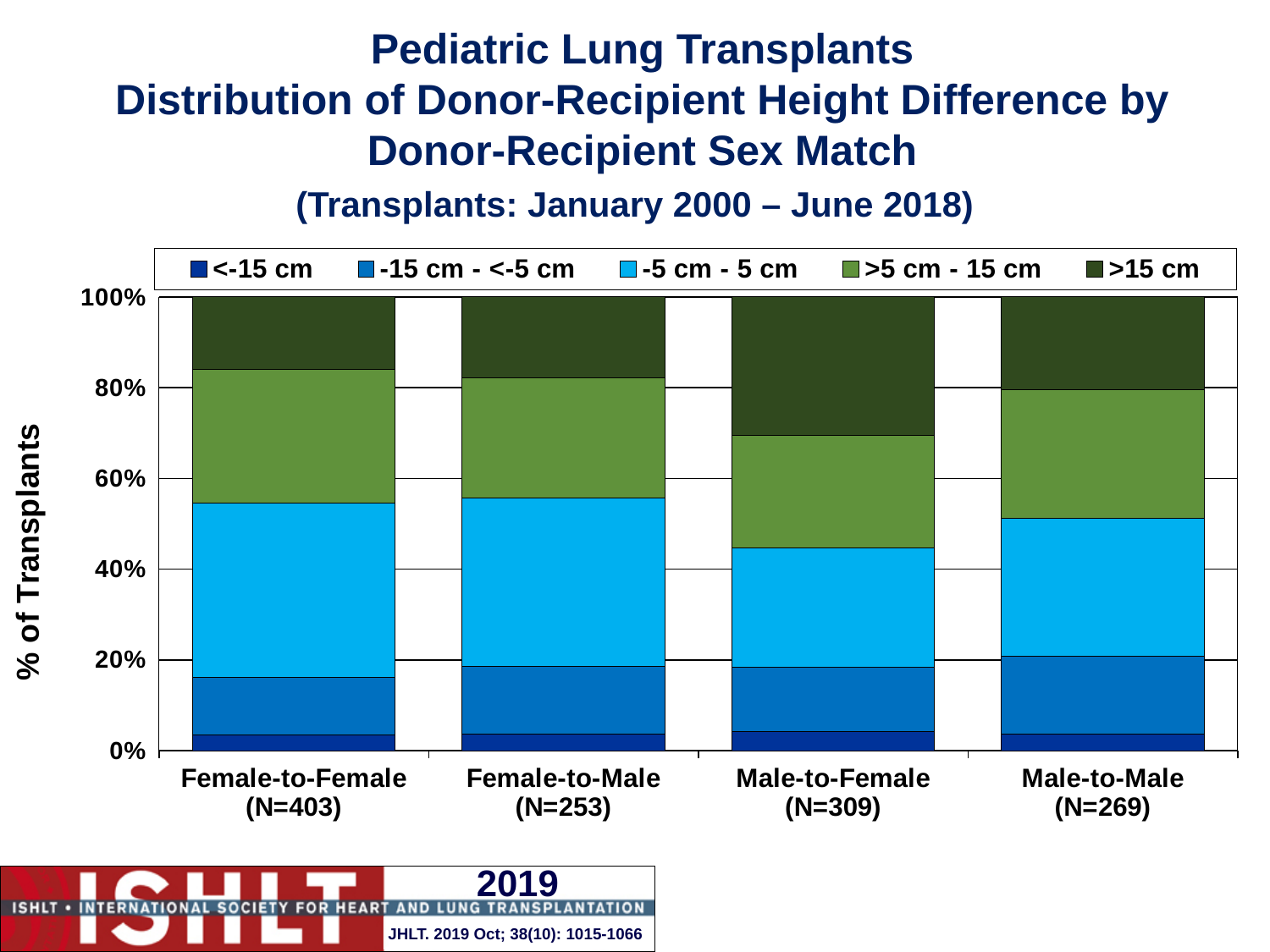
What is the label of the y axis? % of Transplants Which category has the smallest -5 cm - 5 cm segment? Male-to-Female Is the -5 cm - 5 cm share for Female-to-Female greater or less than 20%? greater How many height-difference series does the legend list? 5 Which is larger, the >15 cm segment for Male-to-Female or for Female-to-Female? Male-to-Female Which category has the smallest N shown in its label? Female-to-Male (N=253) What is the total height of each stacked bar? 100% Which category has the largest >15 cm segment? Male-to-Female What kind of chart is shown on the slide? Stacked bar chart Is the >15 cm share for Male-to-Female greater or less than 20%? greater What is the N shown for the Female-to-Female category? N=403 How many donor-recipient sex match categories are shown on the x axis? 4